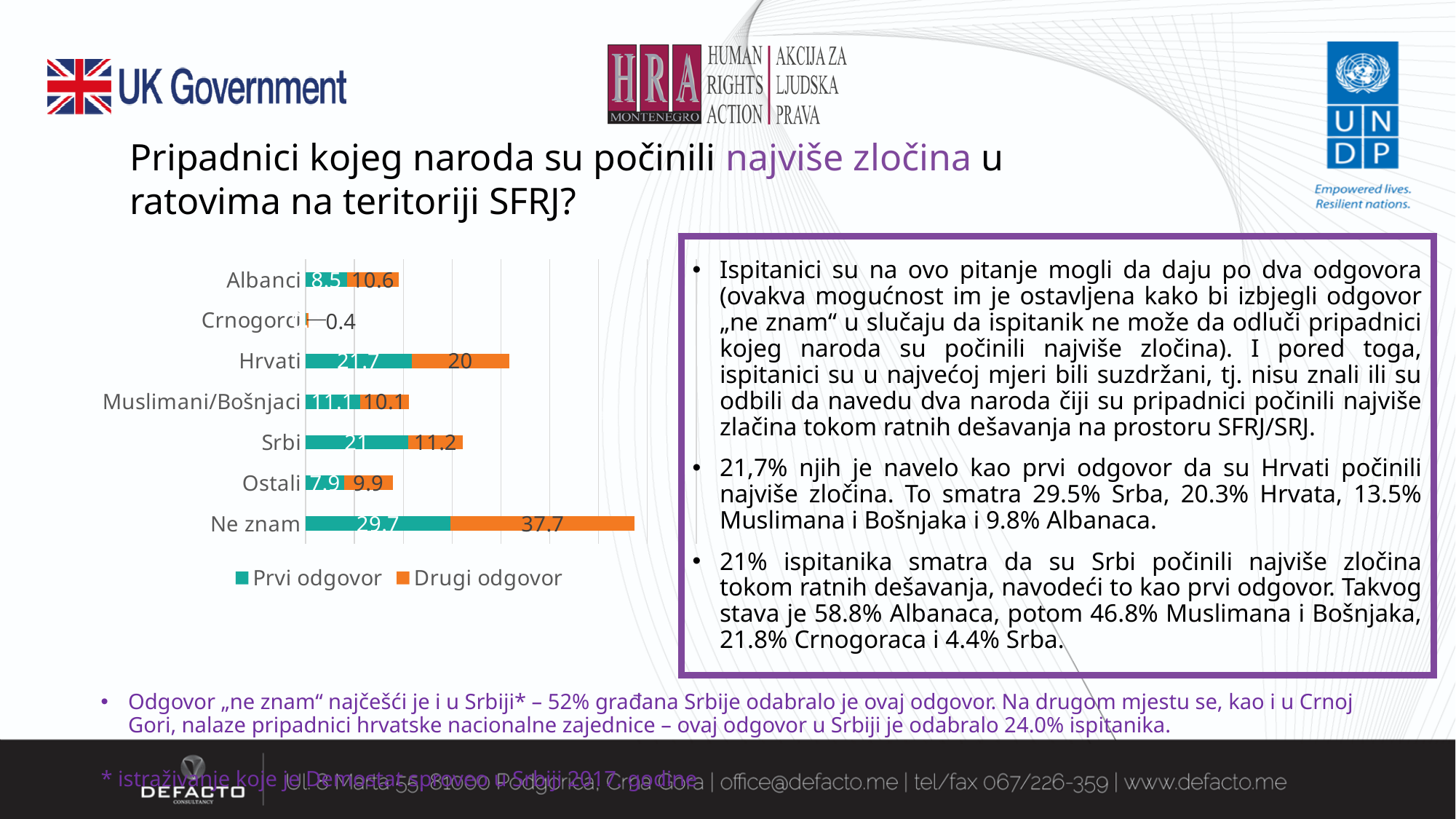
What is the total of the stacked bar for Hrvati? 41.7 What is the Drugi odgovor value for Albanci? 10.6 How many categories are shown on the chart? 7 Which has the larger Prvi odgovor value, Hrvati or Srbi? Hrvati What is the Prvi odgovor value for Hrvati? 21.7 How many series does the legend list? 2 What is the Prvi odgovor value for Srbi? 21 Which category has the lowest Drugi odgovor value? Crnogorci Which category has the highest Prvi odgovor value? Ne znam For Ne znam, how much larger is the Drugi odgovor value than the Prvi odgovor value? 8 What is the Drugi odgovor value for Ne znam? 37.7 What kind of chart is shown on the slide? Stacked bar chart